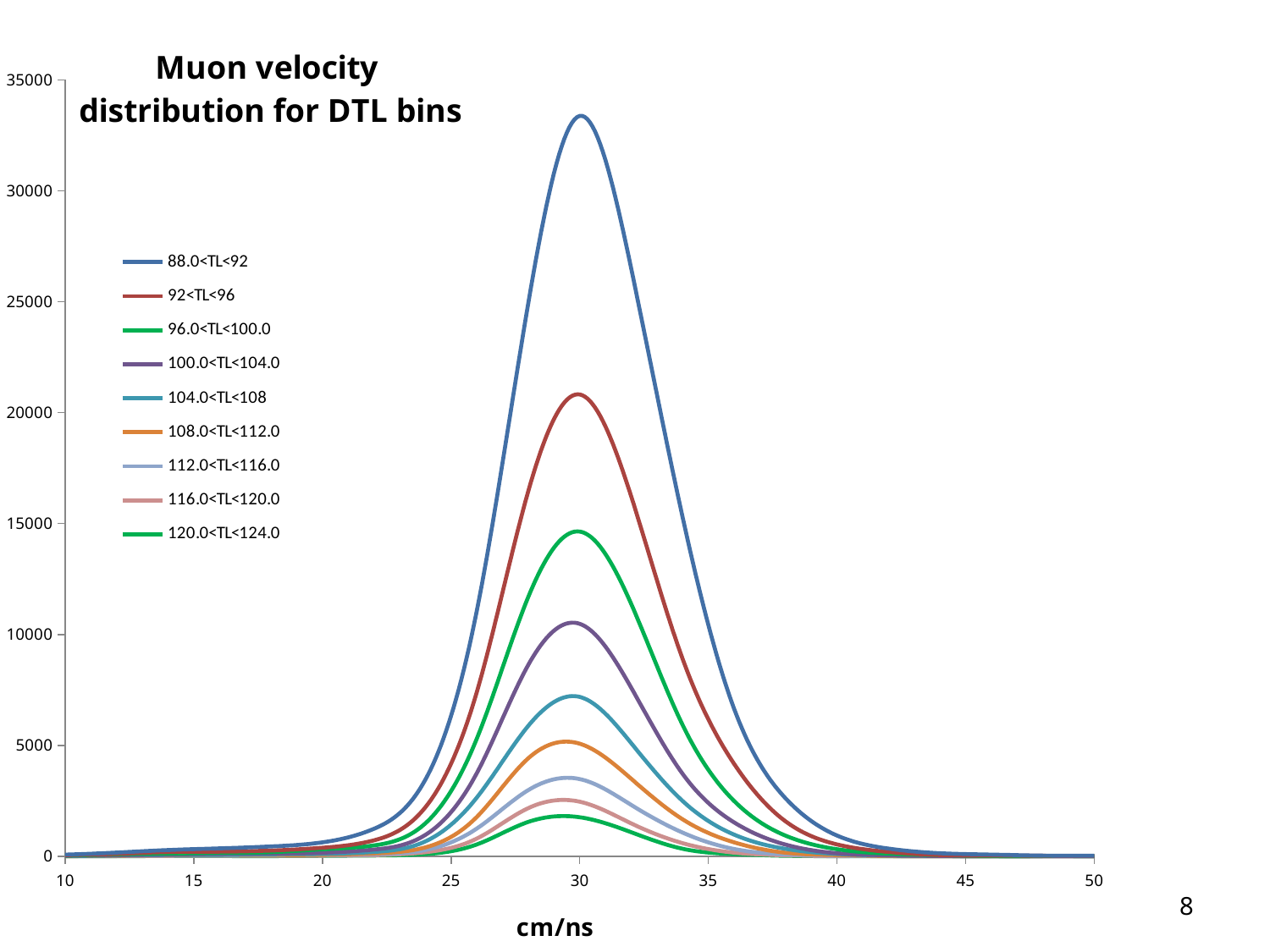
What kind of chart is shown on the slide? Line chart Is the peak value of the 104.0<TL<108 series greater or less than 5000? greater Is the peak value of the 88.0<TL<92 series greater or less than 30000? greater Is the x value at which the 88.0<TL<92 curve peaks greater or less than 25? greater Which series has the lowest peak value? 120.0<TL<124.0 What is the label on the x axis? cm/ns What is the title of the chart? Muon velocity distribution for DTL bins Which series has a higher peak, 92<TL<96 or 96.0<TL<100.0? 92<TL<96 How many series does the legend list? 9 Which series reaches the highest peak value? 88.0<TL<92